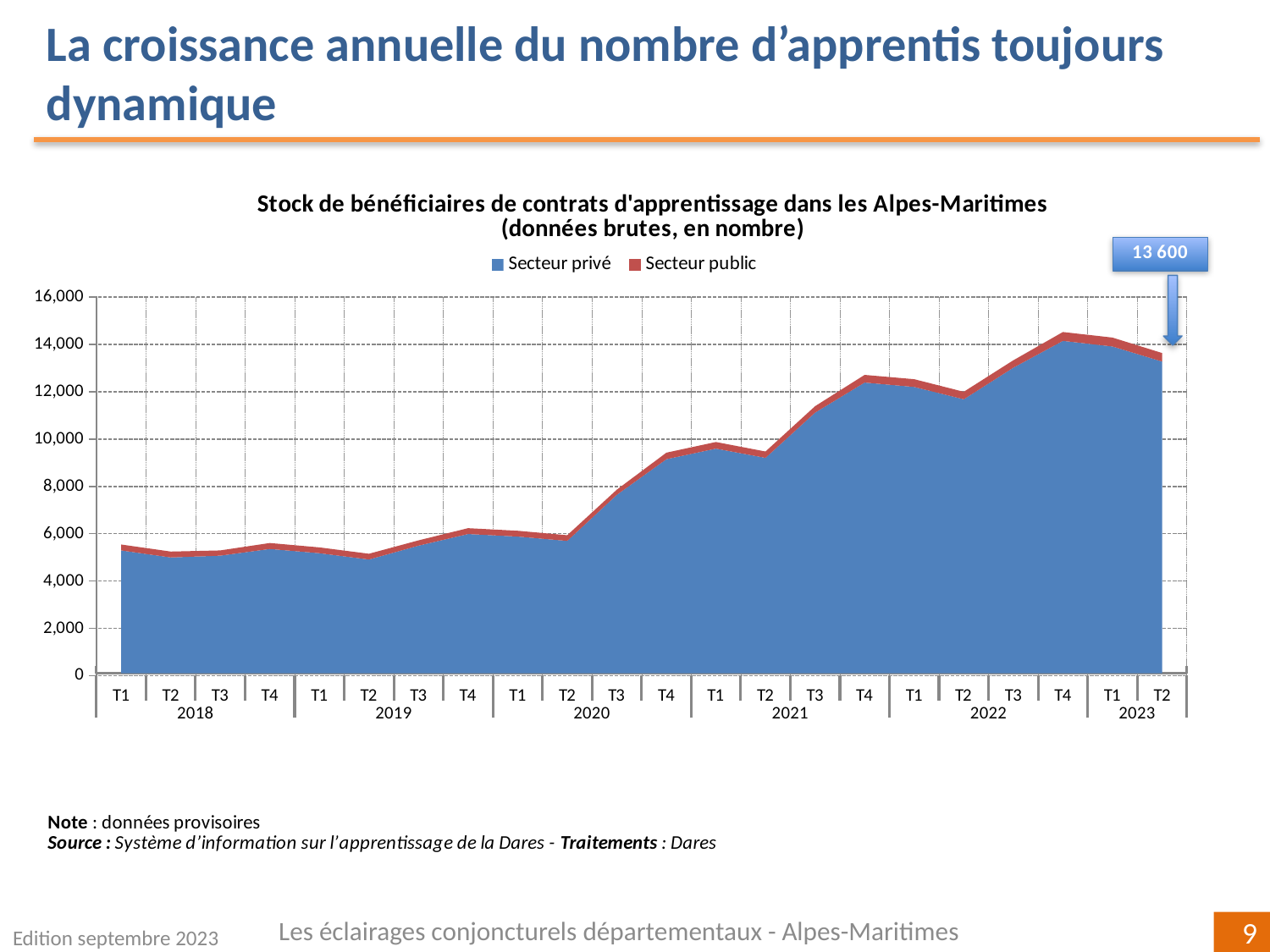
Which series accounts for the larger part of the stock, Secteur privé or Secteur public? Secteur privé Is the total value for T4 2021 greater or less than 12,000? greater Is the total value for T4 2022 greater or less than 14,000? greater Is the total value for T1 2018 greater or less than 6,000? less Does the total stock generally rise or fall from 2018 to 2023? rise What type of chart is shown on the slide? area chart How many quarters are plotted along the x axis? 22 What is the total stock of apprenticeship beneficiaries indicated for T2 2023? 13 600 How many series does the legend list? 2 In which quarter does the total stock reach its highest level? T4 2022 Which is larger, the total for T4 2019 or the total for T4 2021? T4 2021